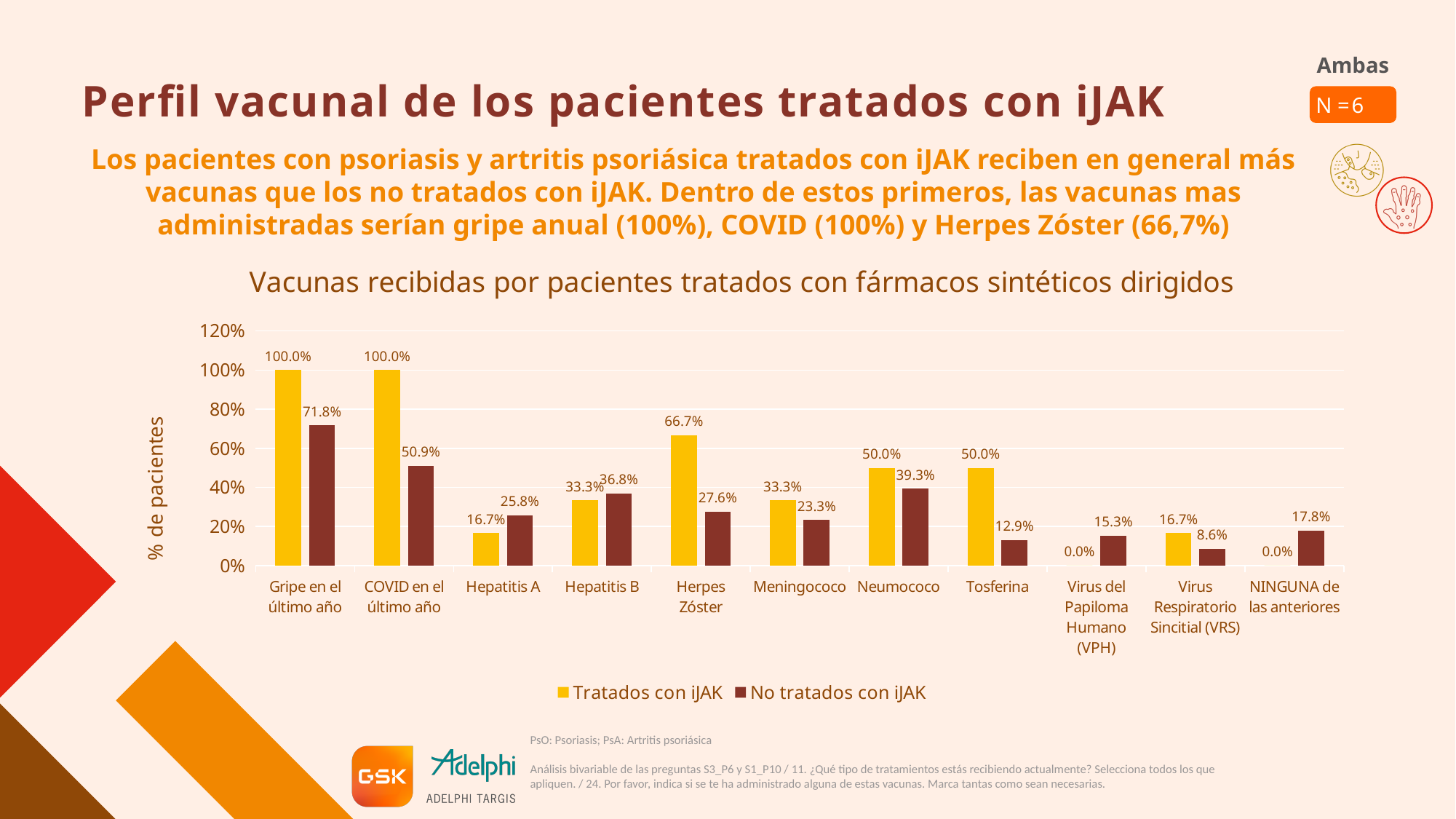
What is the value for Tosferina in the 'No tratados con iJAK' series? 12.9% How many vaccine categories are shown on the x axis? 11 What is the value for Herpes Zóster in the 'Tratados con iJAK' series? 66.7% What is the value for NINGUNA de las anteriores in the 'Tratados con iJAK' series? 0.0% How many series does the legend list? 2 For Hepatitis A, which series has the larger value: 'Tratados con iJAK' or 'No tratados con iJAK'? No tratados con iJAK What is the value for Virus Respiratorio Sincitial (VRS) in the 'No tratados con iJAK' series? 8.6% What is the difference between the 'Tratados con iJAK' and 'No tratados con iJAK' values for COVID en el último año? 49.1% Which category has the highest value in the 'No tratados con iJAK' series? Gripe en el último año What is the title of the chart? Vacunas recibidas por pacientes tratados con fármacos sintéticos dirigidos Which category has the lowest value in the 'No tratados con iJAK' series? Virus Respiratorio Sincitial (VRS) What type of chart is shown on the slide? Bar chart